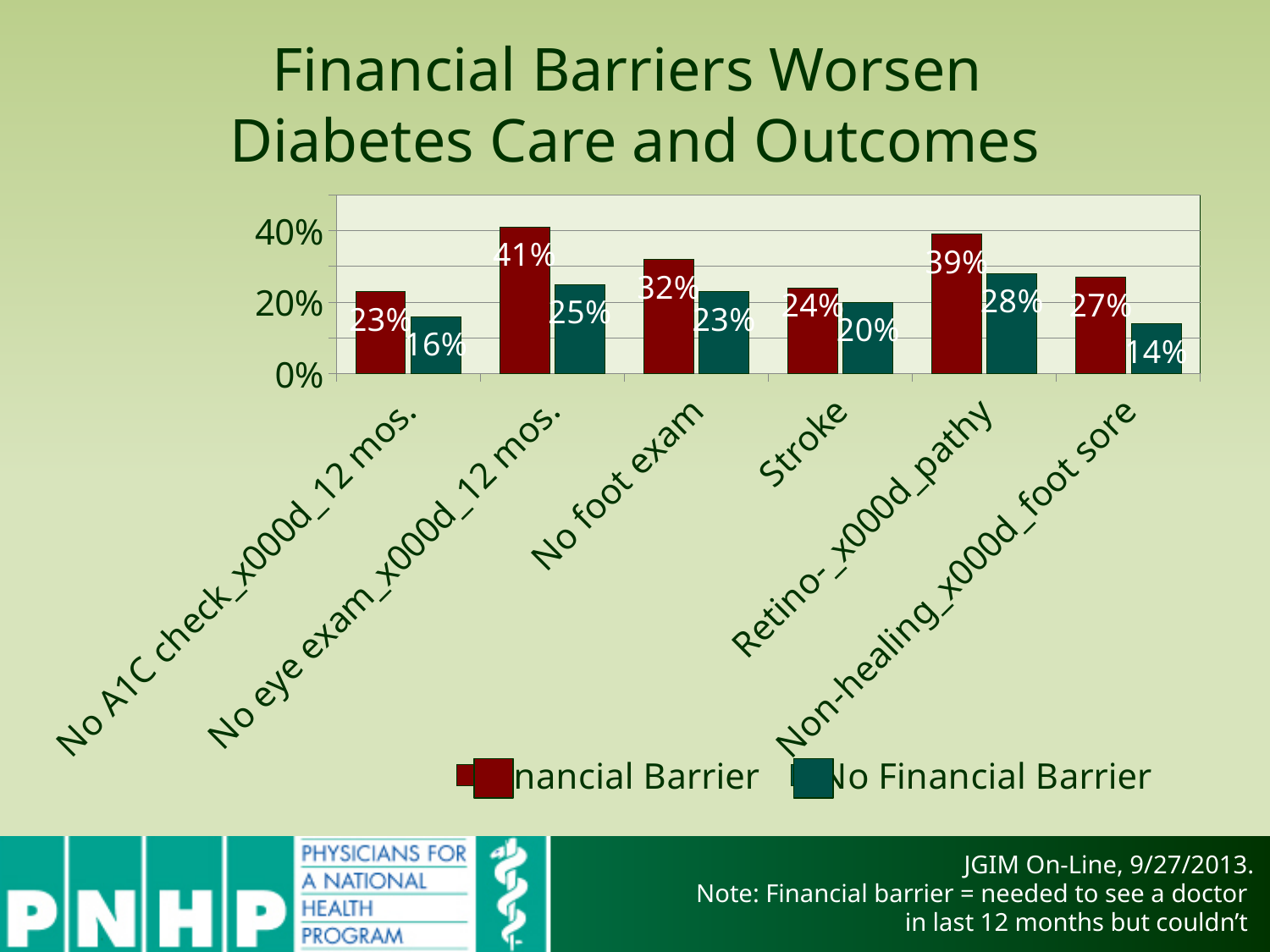
For Stroke, which is larger: the Financial Barrier value or the No Financial Barrier value? Financial Barrier What is the No Financial Barrier value for Non-healing foot sore? 14% Which category has the lowest No Financial Barrier value? Non-healing foot sore How many categories are shown on the x axis of the chart? 6 What is the Financial Barrier value for Stroke? 24% What is the No Financial Barrier value for No foot exam? 23% What is the Financial Barrier value for Retinopathy? 39% Which series is shown in dark red in the chart? Financial Barrier What is the difference between the Financial Barrier and No Financial Barrier values for No eye exam 12 mos.? 16% What type of chart is shown on the slide? bar chart How many series does the chart legend list? 2 Which category has the highest Financial Barrier value? No eye exam 12 mos.